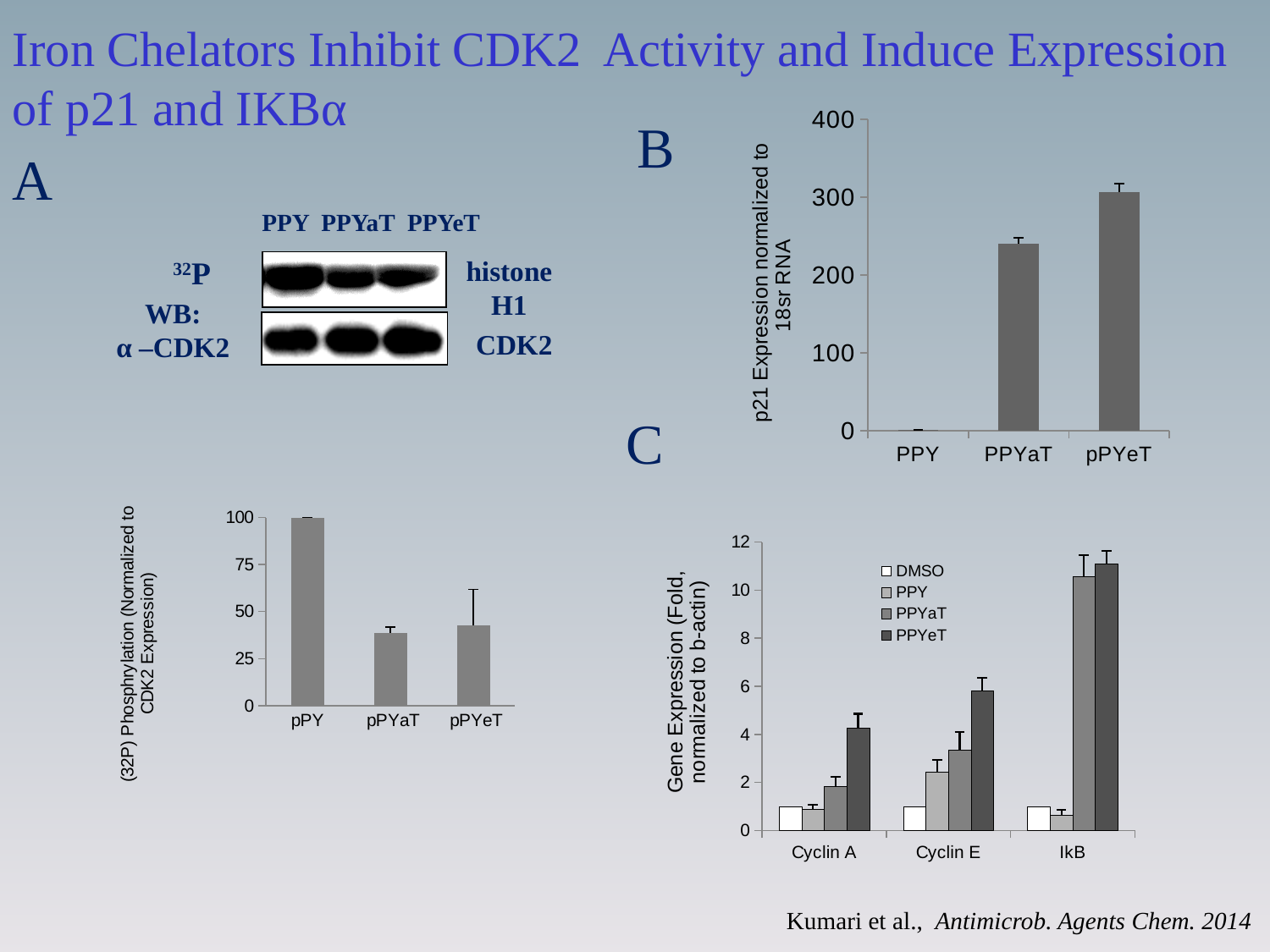
What kind of chart is chart B (p21 expression)? bar chart In the bottom-left chart (32P phosphorylation), is the value for pPY greater or less than 75? greater In chart B (p21 expression), is the value for PPYaT greater or less than 200? greater In chart B (p21 expression), which category has the lowest bar? PPY In chart C (gene expression), is the PPYaT value for IkB greater or less than 8? greater How many categories are shown on the x axis of the bottom-left chart (32P phosphorylation)? 3 In chart B (p21 expression), which category has the highest bar? pPYeT How many series does the legend of chart C (gene expression) list? 4 In chart C (gene expression), which is larger: the PPYeT value for Cyclin A or the PPYeT value for Cyclin E? Cyclin E In the bottom-left chart (32P phosphorylation), which category has the highest bar? pPY